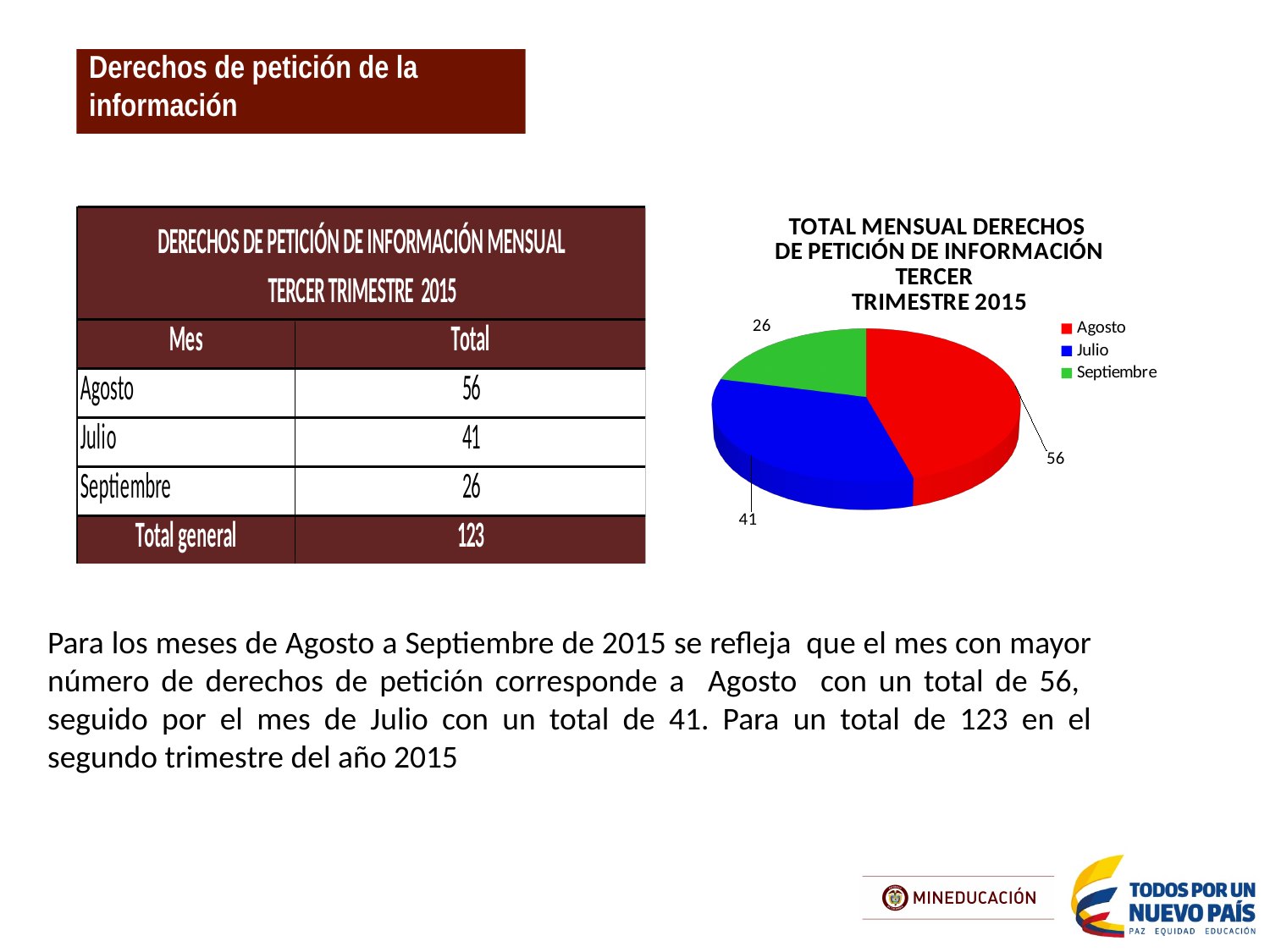
What is the difference between the values for Julio and Septiembre in the pie chart? 15 How many slices does the pie chart have? 3 What is the value for Agosto in the pie chart? 56 What is the value for Julio in the pie chart? 41 Which is larger in the pie chart, the value for Julio or the value for Septiembre? Julio What colour is the Julio slice in the pie chart? blue Which month has the largest slice in the pie chart? Agosto What is the value for Septiembre in the pie chart? 26 What type of chart is shown on the slide? pie chart What is the difference between the values for Agosto and Julio in the pie chart? 15 How many entries does the legend of the pie chart list? 3 Which month has the smallest slice in the pie chart? Septiembre